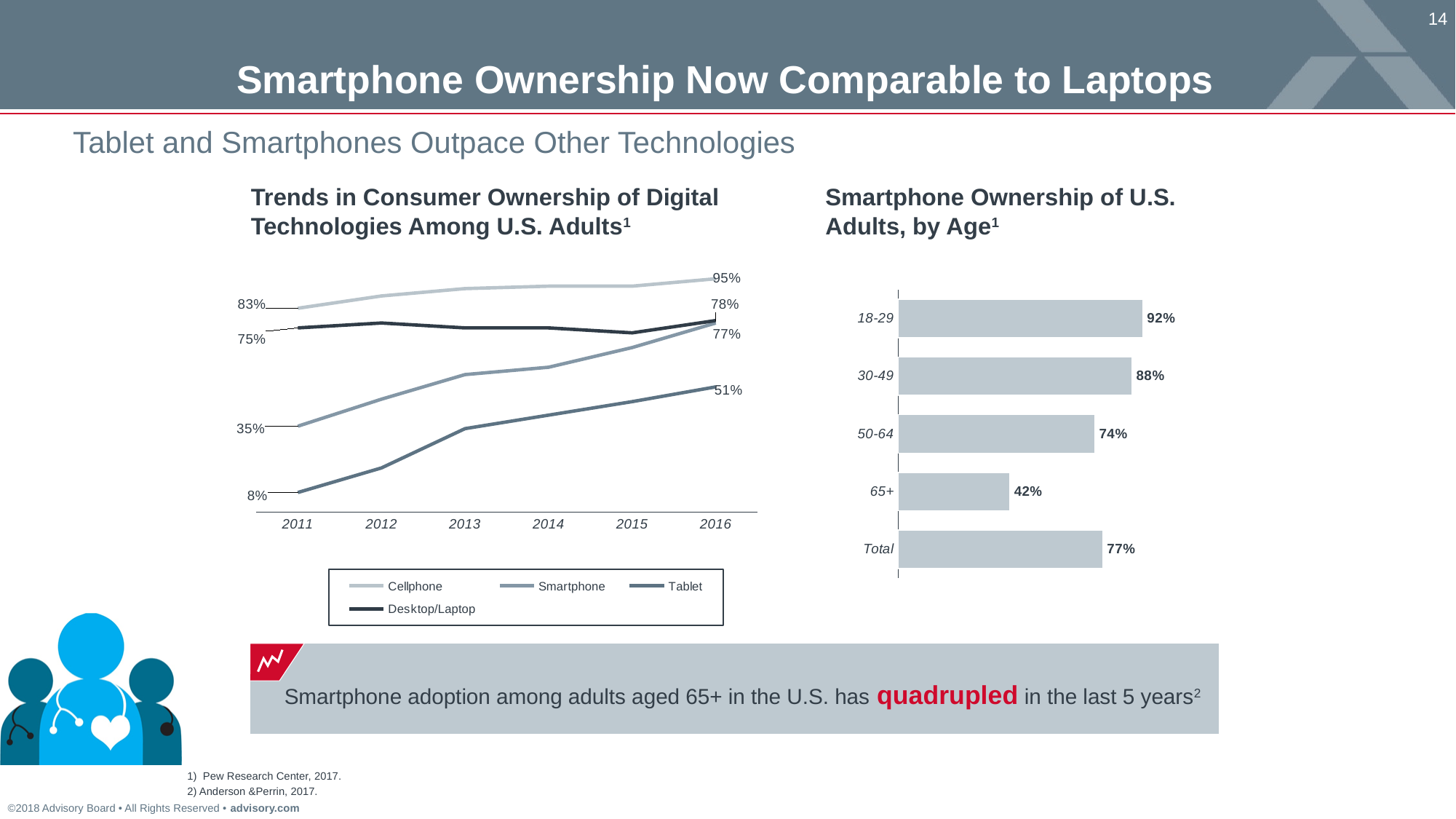
In the 'Trends in Consumer Ownership of Digital Technologies Among U.S. Adults' chart, by how much did Smartphone ownership change from 2011 (35%) to 2016 (77%)? 42% In the 'Trends in Consumer Ownership of Digital Technologies Among U.S. Adults' chart, how many series does the legend list? 4 In the 'Trends in Consumer Ownership of Digital Technologies Among U.S. Adults' chart, what was the Cellphone ownership value in 2016? 95% In the 'Smartphone Ownership of U.S. Adults, by Age' chart, how many bars are shown? 5 In the 'Smartphone Ownership of U.S. Adults, by Age' chart, which age group has the lowest smartphone ownership? 65+ In the 'Smartphone Ownership of U.S. Adults, by Age' chart, what is the value for the 65+ age group? 42% In the 'Trends in Consumer Ownership of Digital Technologies Among U.S. Adults' chart, does Smartphone ownership rise or fall from 2011 to 2016? Rise In the 'Trends in Consumer Ownership of Digital Technologies Among U.S. Adults' chart, what was the Tablet ownership value in 2011? 8% In the 'Smartphone Ownership of U.S. Adults, by Age' chart, which age group has the highest smartphone ownership? 18-29 In the 'Smartphone Ownership of U.S. Adults, by Age' chart, what is the difference between the 30-49 and 50-64 age groups? 14% What kind of chart is 'Smartphone Ownership of U.S. Adults, by Age'? Bar chart In the 'Smartphone Ownership of U.S. Adults, by Age' chart, what is the value for the 18-29 age group? 92%